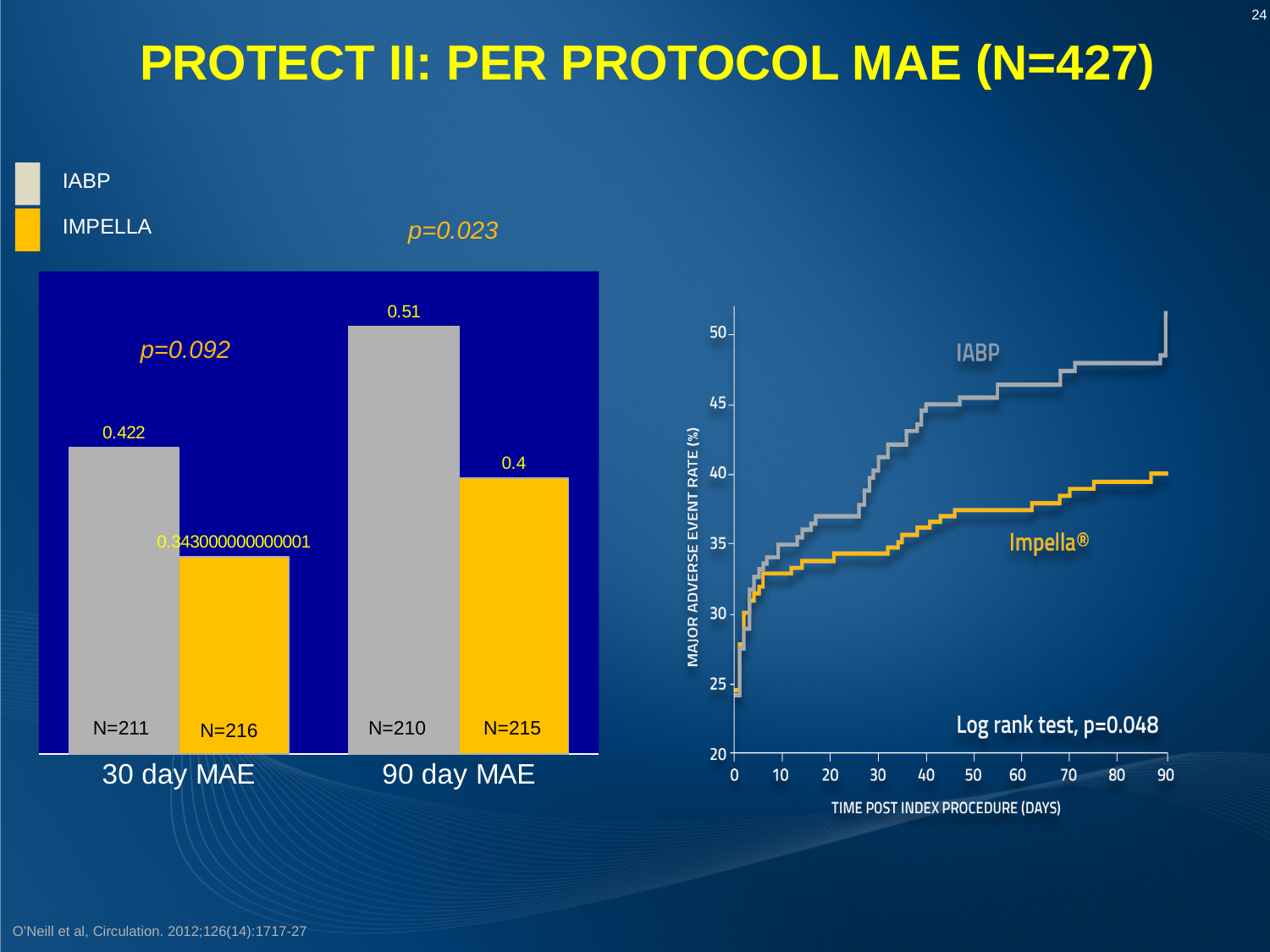
In the bar chart on the left, what is the value for IABP at 90 day MAE? 0.51 How many series does the legend of the bar chart on the left list? 2 In the bar chart on the left, what is the value for IMPELLA at 90 day MAE? 0.4 In the bar chart on the left, which bar has the highest value? IABP at 90 day MAE In the chart on the right, is the Impella major adverse event rate at day 90 greater or less than 45? less In the bar chart on the left, at 30 day MAE, which is larger: IABP or IMPELLA? IABP How many categories are shown on the x axis of the bar chart on the left? 2 In the chart on the right, is the IABP major adverse event rate at day 90 greater or less than 45? greater What kind of chart is the chart on the left of the slide? bar chart In the chart on the right, what p-value is given for the log rank test? p=0.048 In the bar chart on the left, what is the value for IABP at 30 day MAE? 0.422 In the bar chart on the left, what is the difference between the IABP and IMPELLA values at 90 day MAE? 0.11